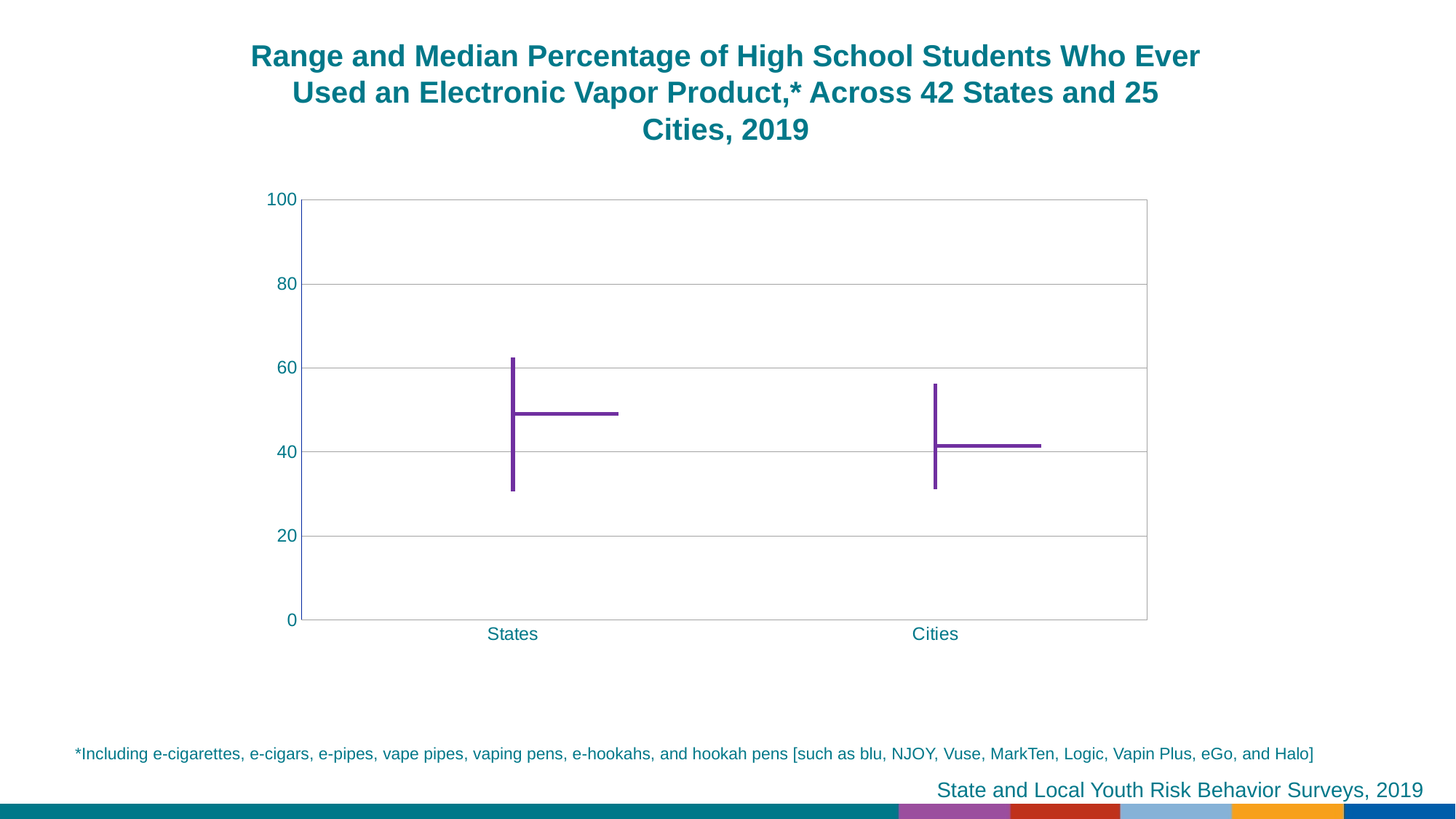
Which category has the lower median percentage? Cities How many categories are shown on the x axis of the chart? 2 Is the median value for States greater or less than 40? greater Is the top of the range for States greater or less than 60? greater Is the bottom of the range for States greater or less than 20? greater Does the median percentage rise or fall from States to Cities? fall What are the two categories shown on the x axis? States and Cities Which category has the higher upper end of its range, States or Cities? States What is the maximum value shown on the y axis of the chart? 100 Which category has the higher median percentage, States or Cities? States